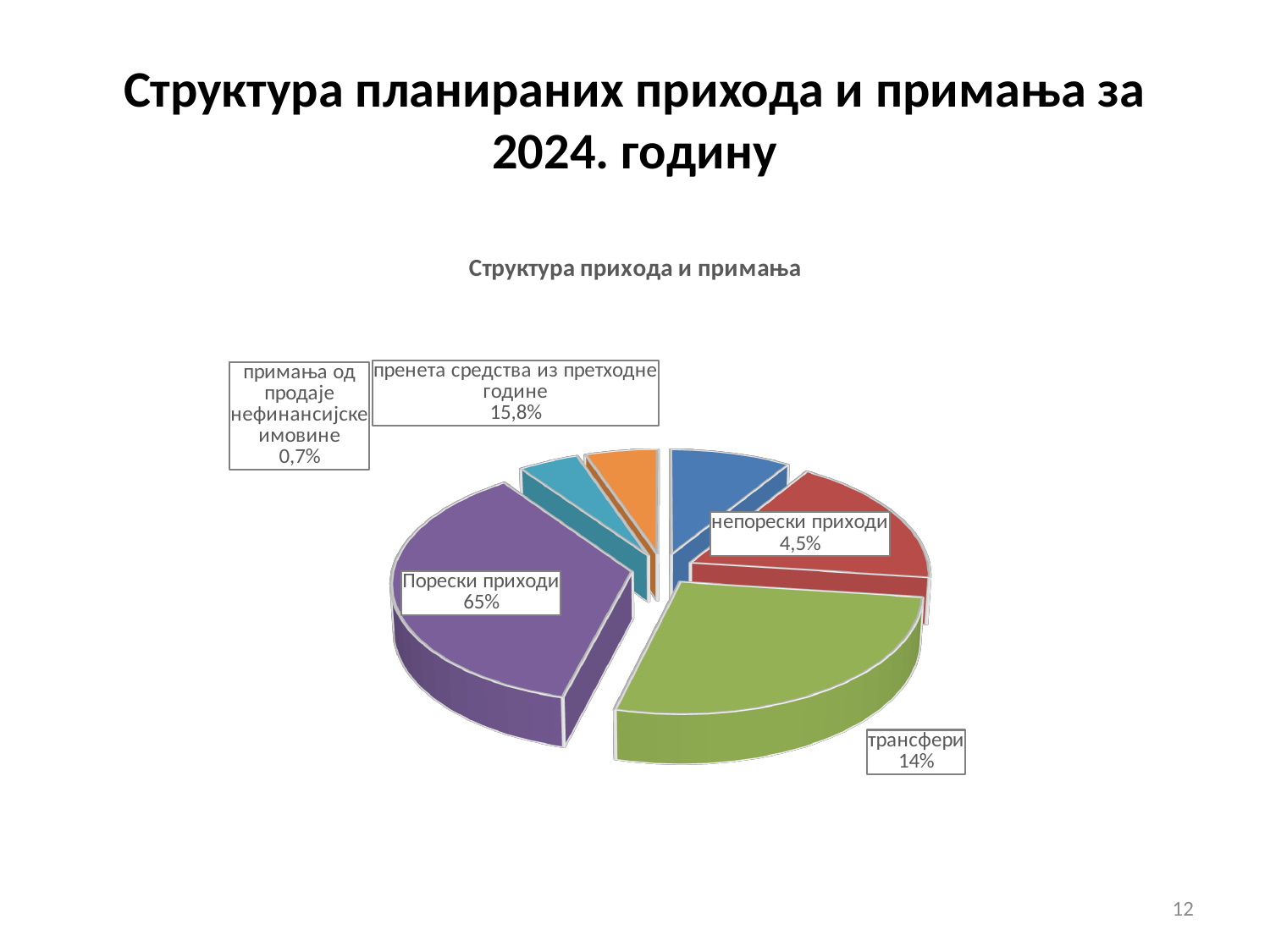
Which is larger, трансфери or пренета средства из претходне године? пренета средства из претходне године What share of the pie is примања од продаје нефинансијске имовине? 0,7% What share of the pie is трансфери? 14% What share of the pie is непорески приходи? 4,5% What is the difference in percentage points between Порески приходи and трансфери? 51 What is the title of the chart? Структура прихода и примања What kind of chart is shown on the slide? pie chart Which category has the smallest share of the pie? примања од продаје нефинансијске имовине Which category has the largest share of the pie? Порески приходи What share of the pie is Порески приходи? 65% What colour is the Порески приходи slice? purple What share of the pie is пренета средства из претходне године? 15,8%